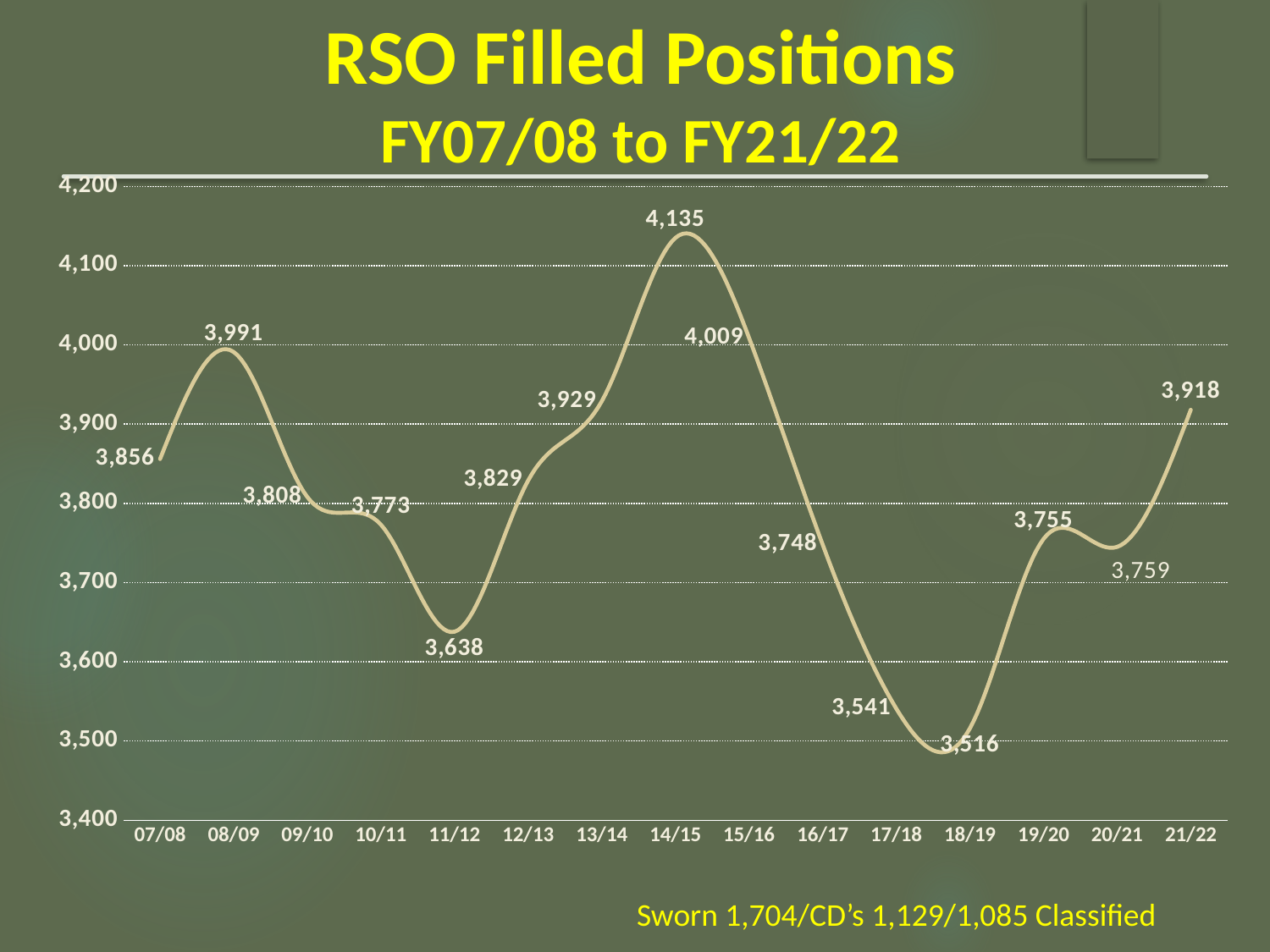
What is the difference between the values for 14/15 and 18/19? 619 Which fiscal year has the lowest value? 18/19 What is the value for 21/22? 3,918 What is the value for 11/12? 3,638 Is the value for 17/18 greater or less than 3,600? less How many fiscal years are plotted on the x axis? 15 What is the value for 14/15? 4,135 Which fiscal year has the highest value? 14/15 Which is larger, the value for 13/14 or the value for 16/17? 13/14 What kind of chart is shown? line chart What is the title of the chart? RSO Filled Positions FY07/08 to FY21/22 What is the difference between the values for 07/08 and 08/09? 135